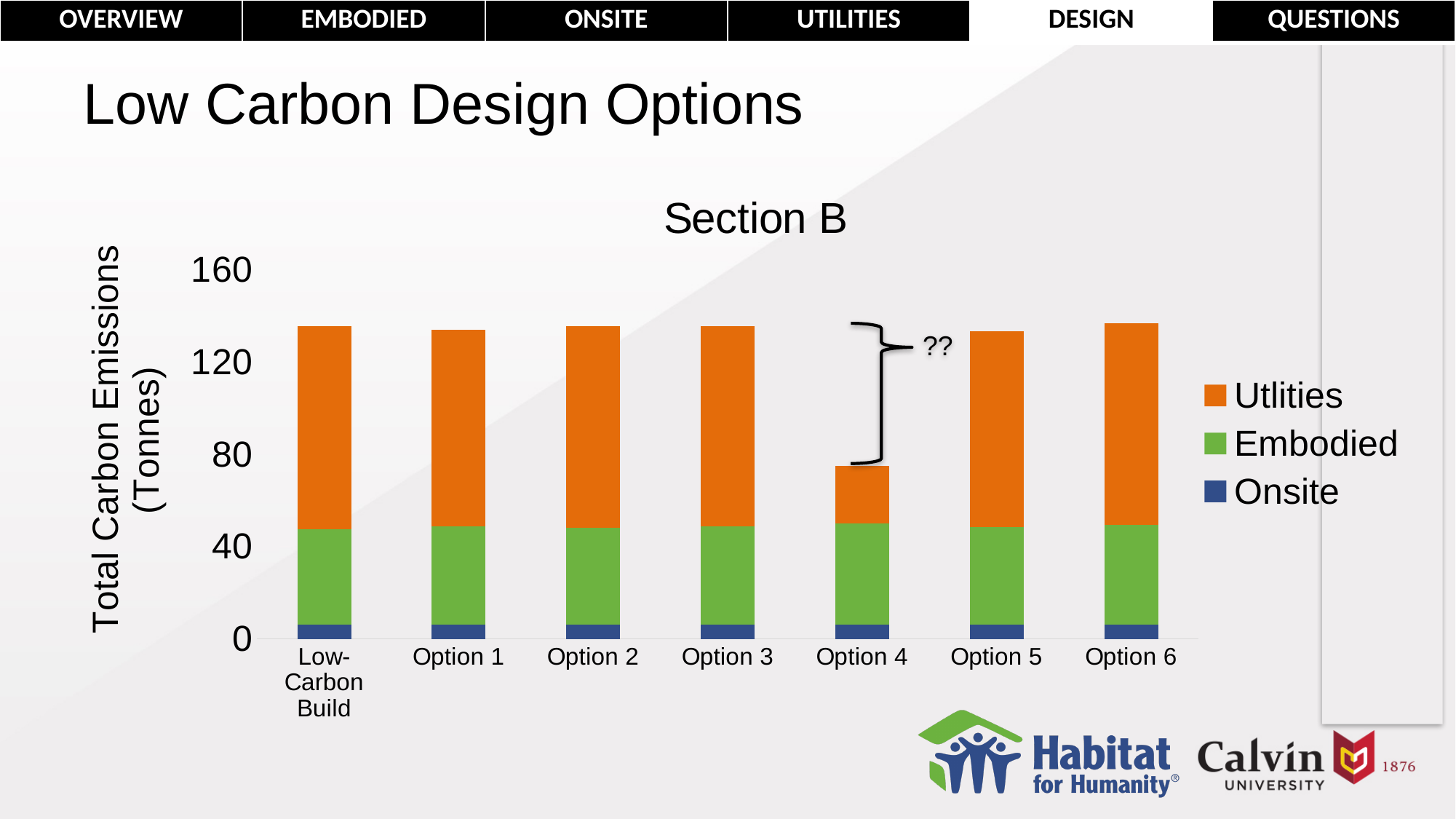
Is the total for Option 4 greater or less than 80? less What is the title of the chart? Section B How many series does the legend list? 3 What kind of chart is shown on the slide? Stacked bar chart Is the total for Option 1 greater or less than 120? greater What is the label of the y axis? Total Carbon Emissions (Tonnes) How many categories are shown on the x axis? 7 Which series is shown in orange? Utlities Which category has the lowest total carbon emissions? Option 4 Which has the larger total carbon emissions, Option 4 or Option 5? Option 5 Is the Onsite value for Option 2 greater or less than 40? less